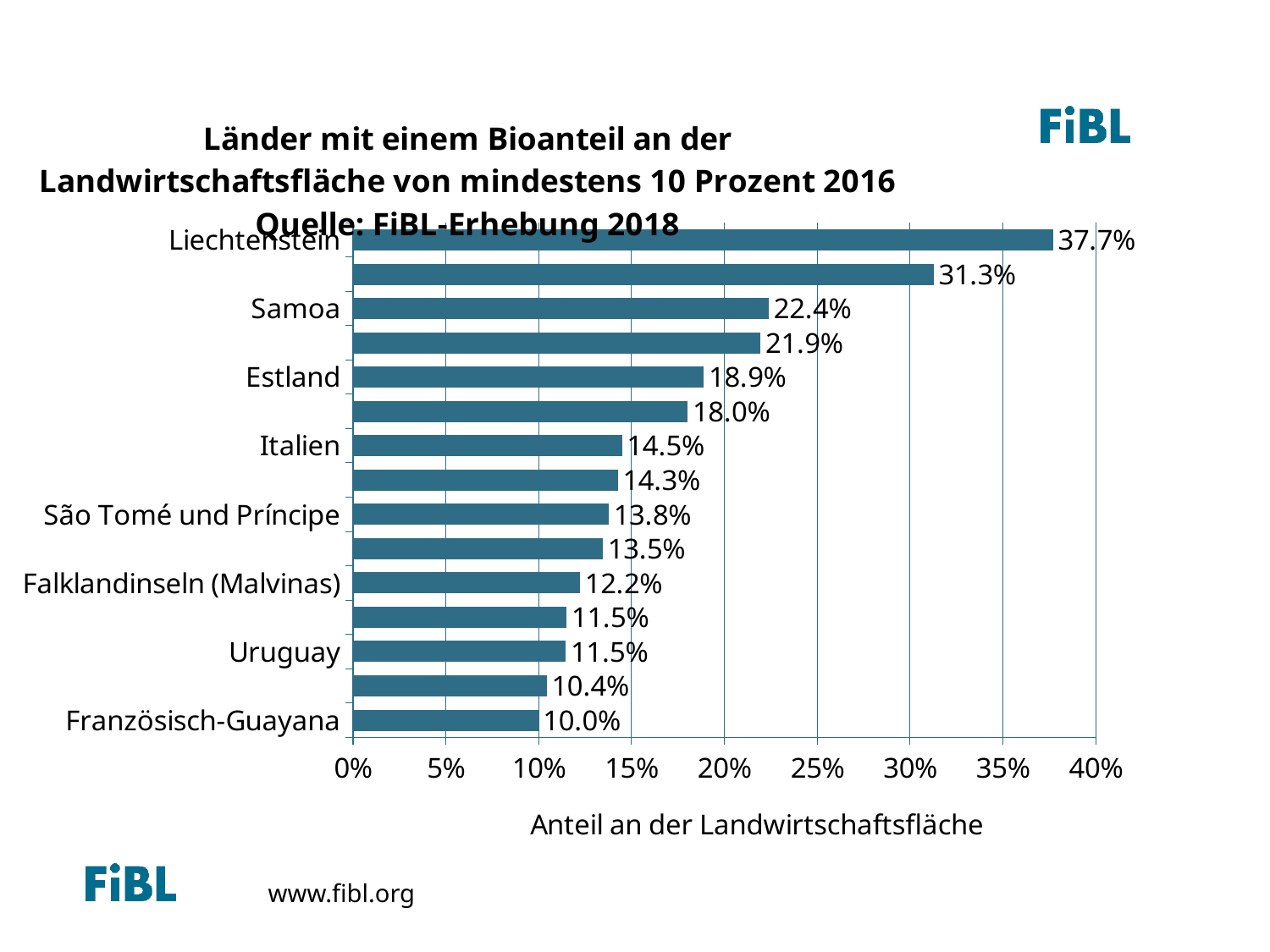
What is the value for Italien? 14.5% What kind of chart is shown on the slide? Bar chart What is the value for Estland? 18.9% What is the difference between the values for Liechtenstein and Samoa? 15.3% What is the value for Samoa? 22.4% What is the value for Französisch-Guayana? 10.0% How many bars are plotted in the chart? 15 What is the value for Liechtenstein? 37.7% Which labelled country has the highest share? Liechtenstein Which labelled country has the lowest share? Französisch-Guayana What is the label of the horizontal axis? Anteil an der Landwirtschaftsfläche Which is larger, the value for Estland or the value for Italien? Estland